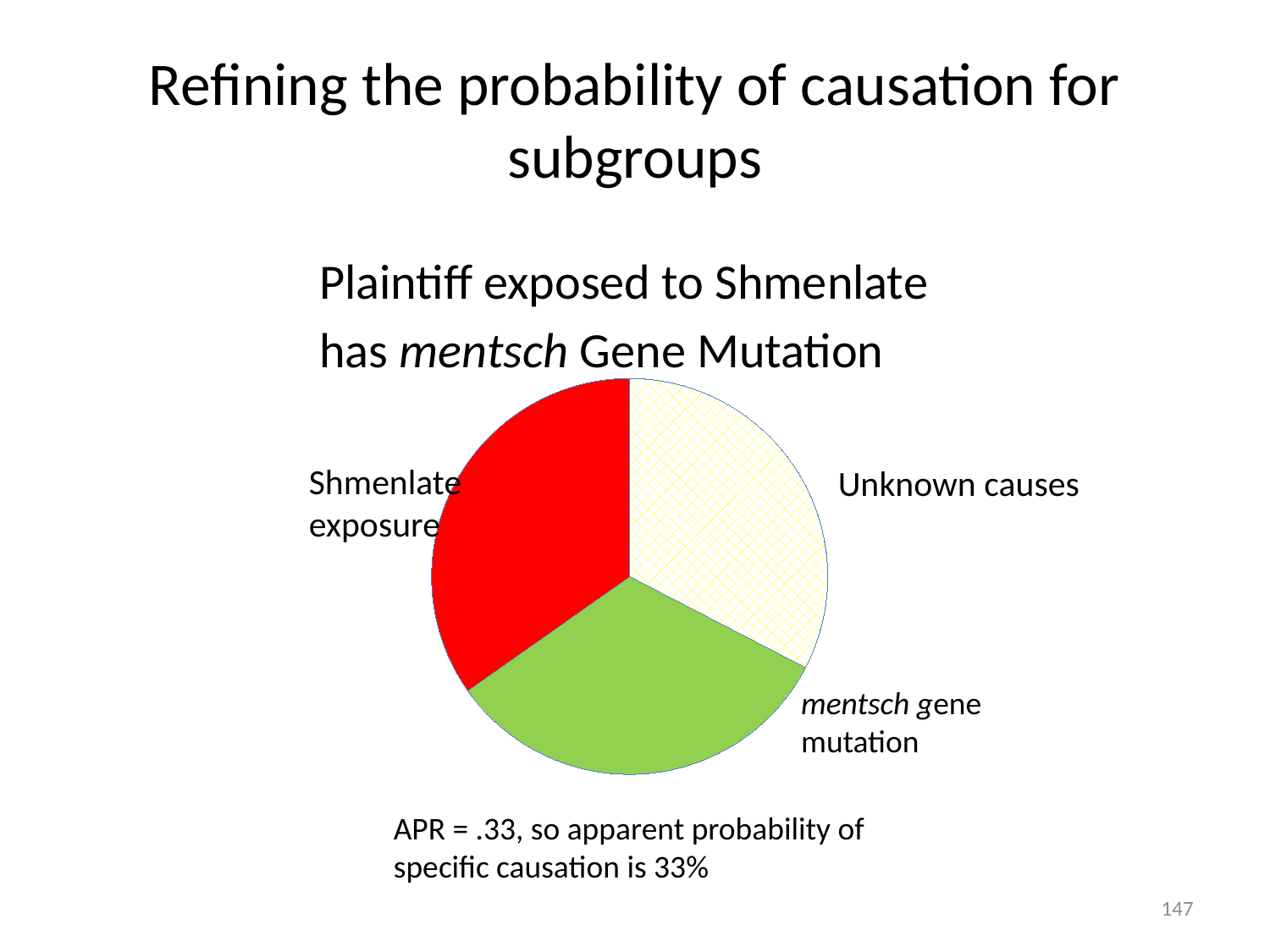
According to the text below the pie chart, what is the apparent probability of specific causation? 33% Which slice of the pie chart is coloured green? mentsch gene mutation What kind of chart is shown on the slide? pie chart How many slices does the pie chart have? 3 What are the three categories labelled on the pie chart? Shmenlate exposure, Unknown causes, mentsch gene mutation What is the APR value stated below the pie chart? .33 Which slice of the pie chart is coloured red? Shmenlate exposure